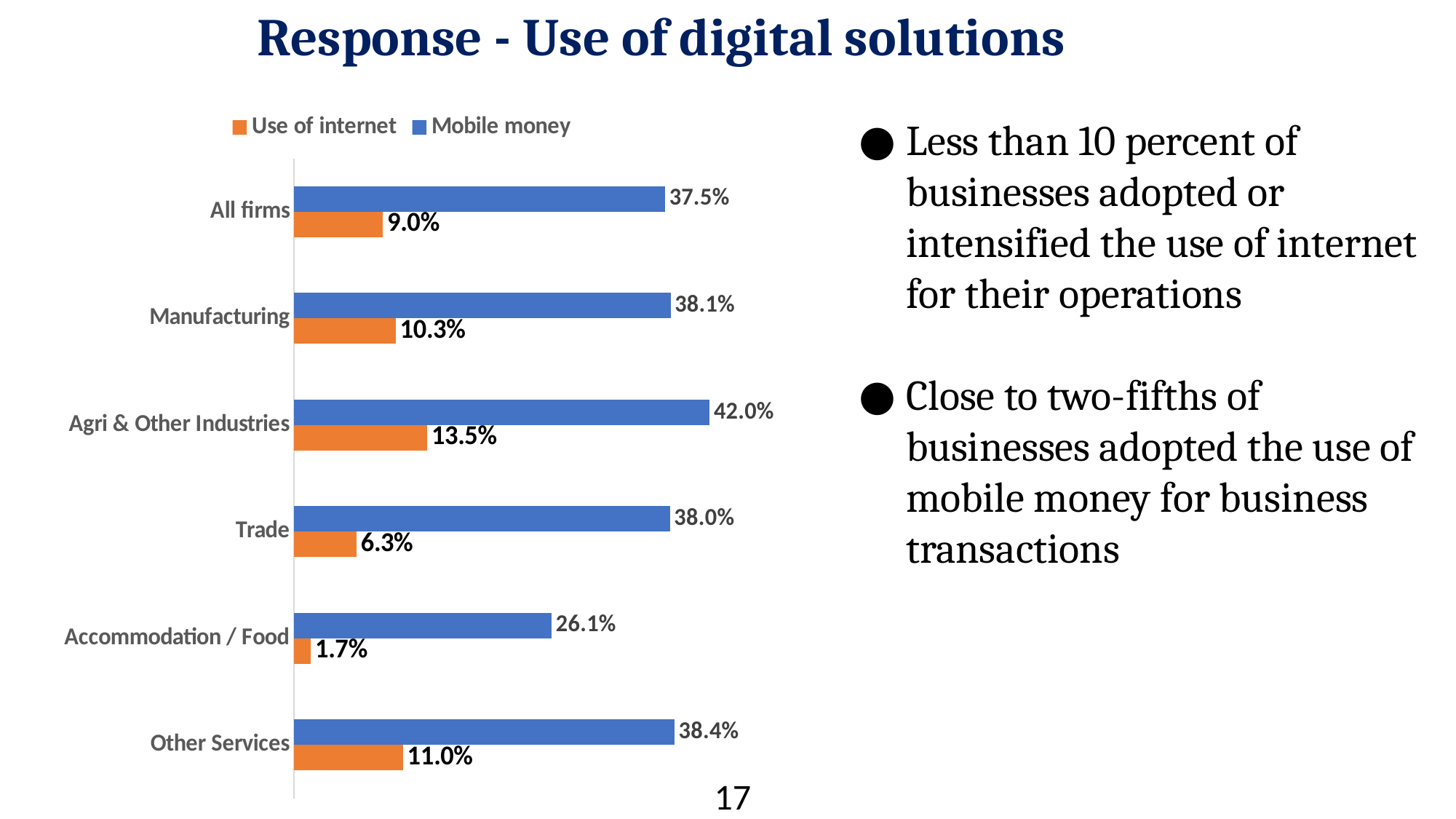
What is the difference between the Mobile money and Use of internet values for Trade? 31.7% How many categories are shown on the chart? 6 Which category has the lowest Use of internet value? Accommodation / Food What is the Use of internet value for Accommodation / Food? 1.7% Which is larger, the Use of internet value for Manufacturing or for Other Services? Other Services Which category has the highest Mobile money value? Agri & Other Industries What kind of chart is shown on the slide? Bar chart What is the Mobile money value for All firms? 37.5% What colour are the Mobile money bars? Blue How many series does the legend list? 2 What is the Use of internet value for Agri & Other Industries? 13.5% What is the Mobile money value for Accommodation / Food? 26.1%